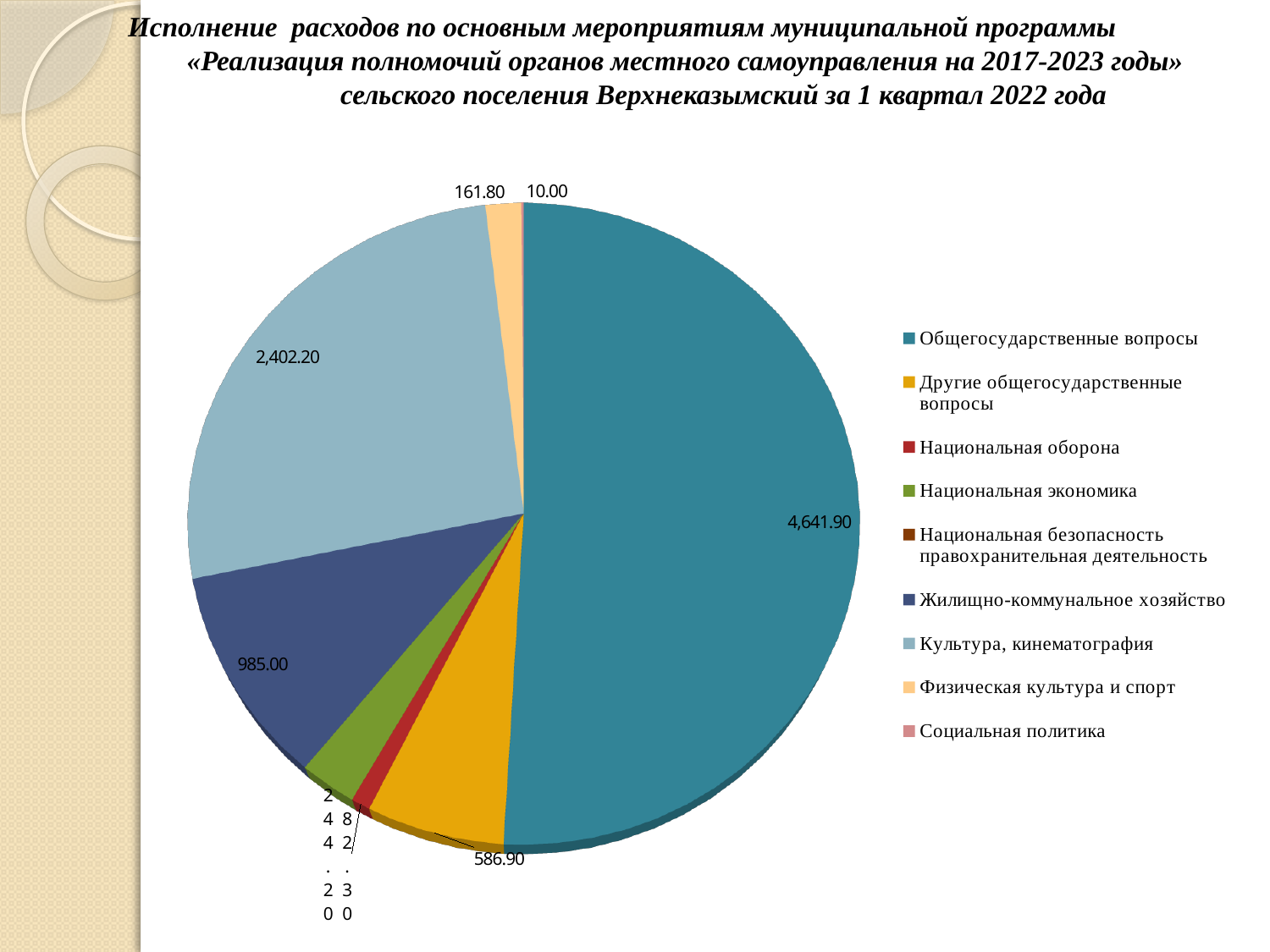
What is the value for Другие общегосударственные вопросы? 586.90 What is the value for Физическая культура и спорт? 161.80 What is the difference between the values for Общегосударственные вопросы and Культура, кинематография? 2,239.70 What is the difference between the values for Жилищно-коммунальное хозяйство and Другие общегосударственные вопросы? 398.10 What is the value for Культура, кинематография? 2,402.20 What kind of chart is shown on the slide? pie chart Which category has the largest slice of the pie? Общегосударственные вопросы What is the value for Социальная политика? 10.00 What is the value for Жилищно-коммунальное хозяйство? 985.00 Which is larger: Культура, кинематография or Жилищно-коммунальное хозяйство? Культура, кинематография How many categories does the legend list? 9 What is the value for Общегосударственные вопросы? 4,641.90